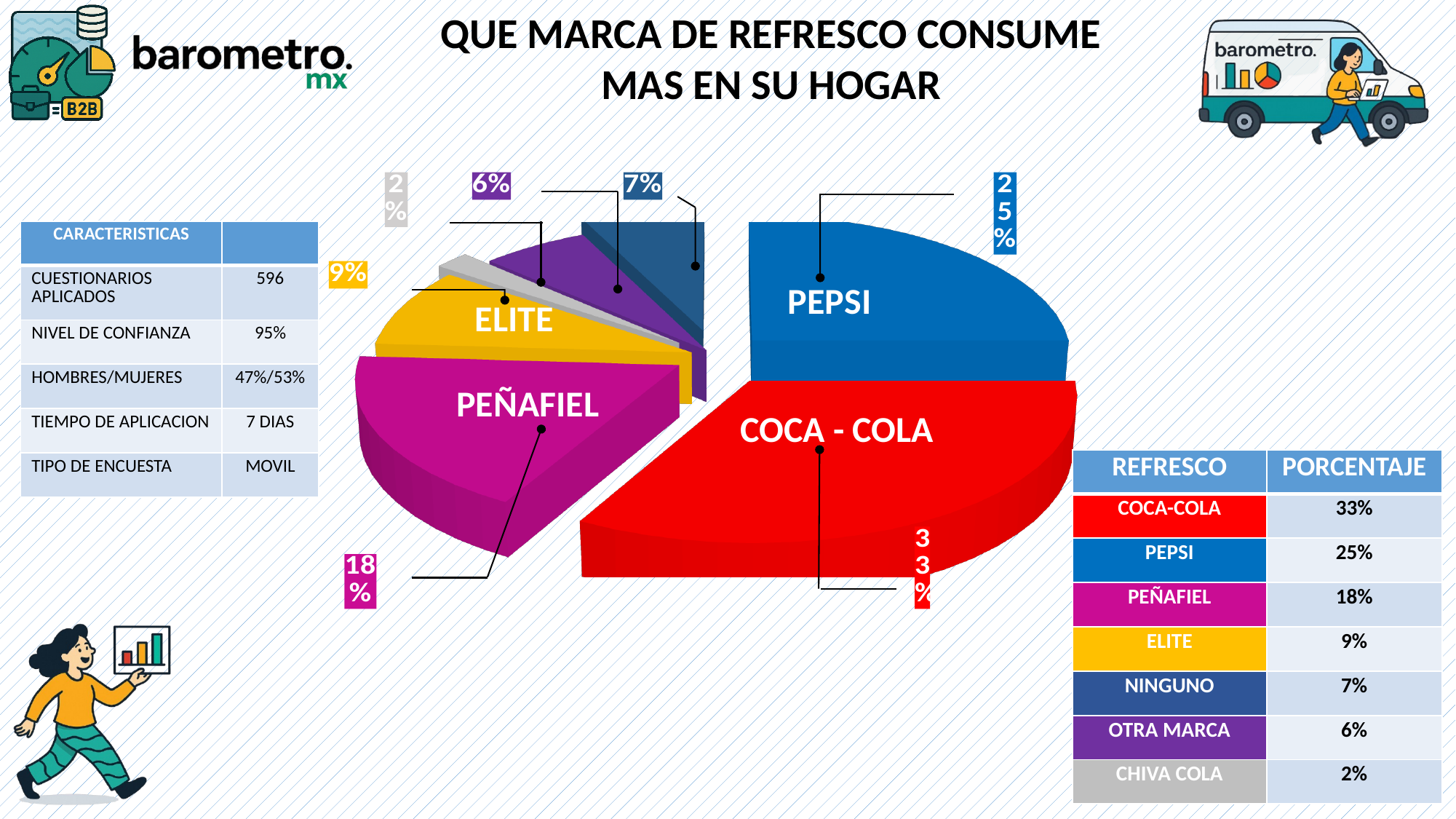
What percentage of the pie chart corresponds to PEÑAFIEL? 18% Which category has the smallest slice of the pie chart? CHIVA COLA What type of chart is shown on the slide? pie chart Which brand has the largest slice of the pie chart? COCA-COLA What percentage of the pie chart corresponds to COCA-COLA? 33% What is the difference in percentage points between COCA-COLA and PEPSI? 8% Which has a larger share, PEÑAFIEL or ELITE? PEÑAFIEL What percentage of the pie chart corresponds to CHIVA COLA? 2% What percentage of the pie chart corresponds to PEPSI? 25% How many slices does the pie chart have? 7 What percentage of the pie chart corresponds to ELITE? 9% What is the title of the chart? QUE MARCA DE REFRESCO CONSUME MAS EN SU HOGAR